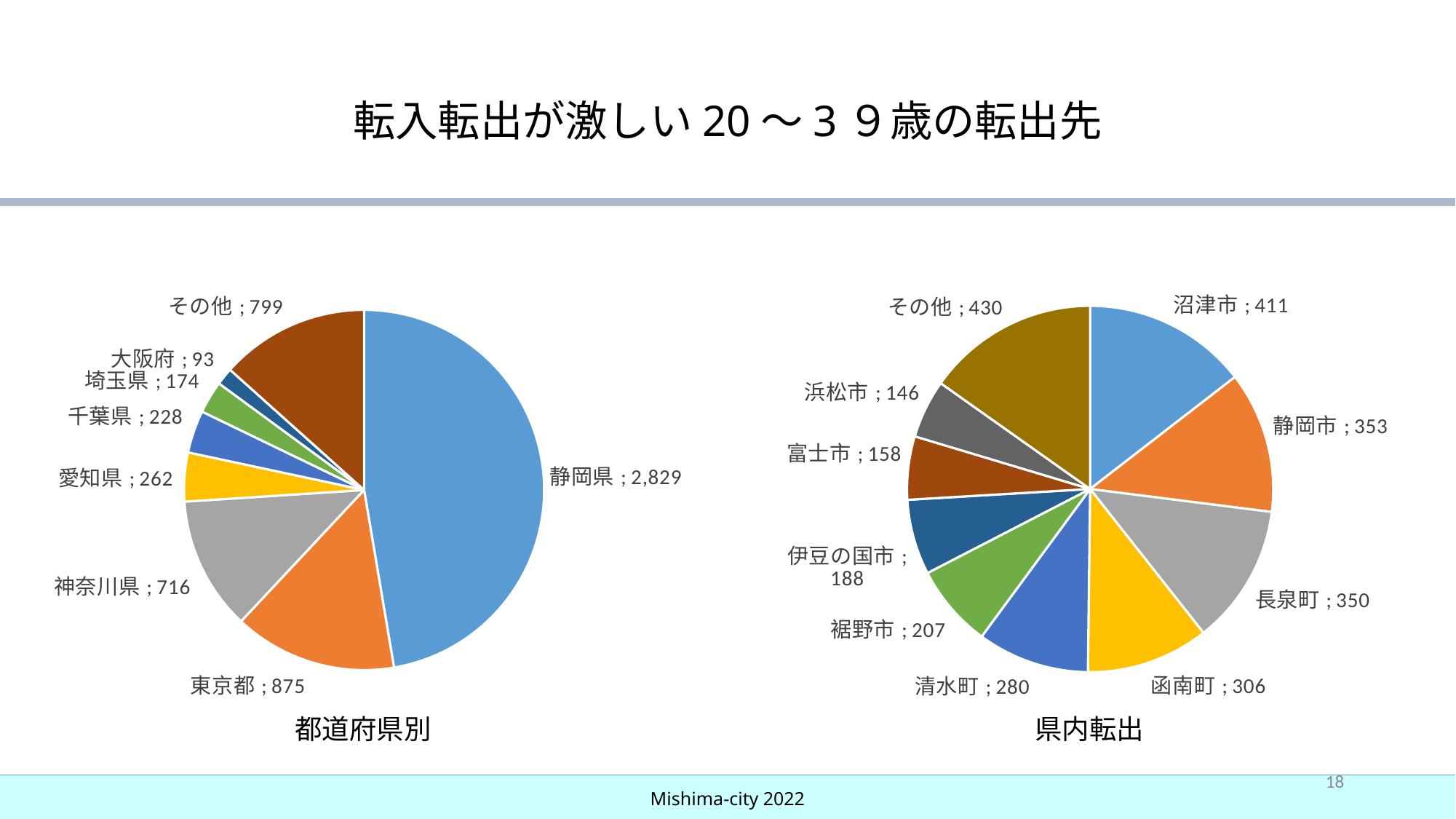
How many slices does the 県内転出 pie chart on the right have? 10 In the 都道府県別 pie chart on the left, what is the value for 東京都? 875 In the 県内転出 pie chart on the right, what is the difference between 沼津市 and 静岡市? 58 In the 都道府県別 pie chart on the left, which is larger, 千葉県 or 埼玉県? 千葉県 In the 都道府県別 pie chart on the left, which category has the smallest value? 大阪府 In the 県内転出 pie chart on the right, what is the value for 長泉町? 350 In the 都道府県別 pie chart on the left, what is the value for 静岡県? 2,829 What type of chart is used for 都道府県別 on the left? Pie chart In the 県内転出 pie chart on the right, which category has the smallest value? 浜松市 In the 県内転出 pie chart on the right, which named municipality (excluding その他) has the largest value? 沼津市 In the 都道府県別 pie chart on the left, what is the difference between 東京都 and 神奈川県? 159 In the 県内転出 pie chart on the right, what is the value for 伊豆の国市? 188